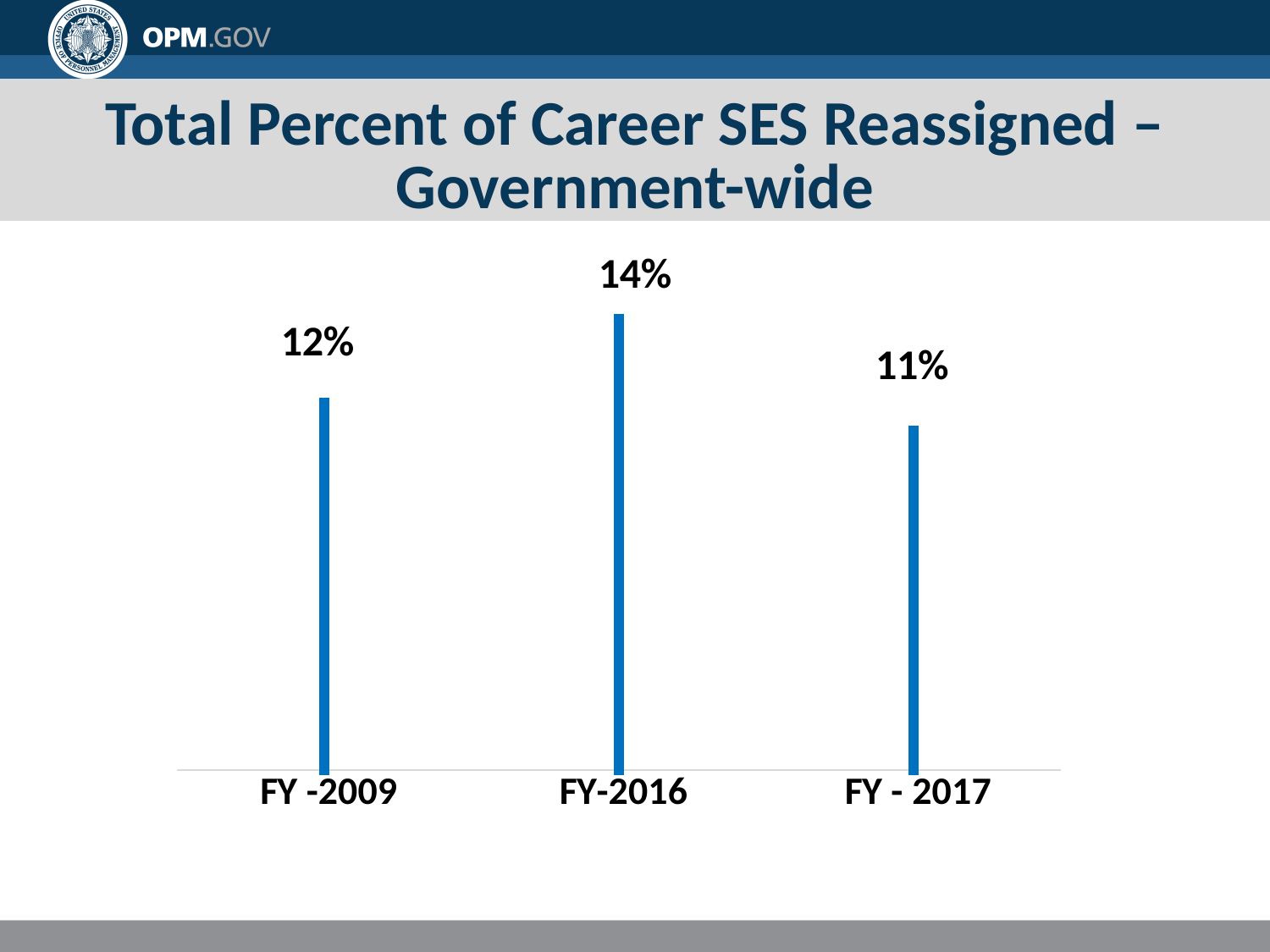
What is the title of the chart on the slide? Total Percent of Career SES Reassigned – Government-wide What kind of chart is shown on the slide? Bar chart Which is larger, the value for FY -2009 or the value for FY - 2017? FY -2009 What is the value for FY-2016? 14% What is the value for FY - 2017? 11% What is the value for FY -2009? 12% What is the difference between the values for FY-2016 and FY -2009? 2% Which fiscal year has the highest percent of career SES reassigned? FY-2016 How many fiscal years are shown on the chart? 3 What is the difference between the values for FY-2016 and FY - 2017? 3% Which fiscal year has the lowest percent of career SES reassigned? FY - 2017 Does the value rise or fall from FY-2016 to FY - 2017? Fall